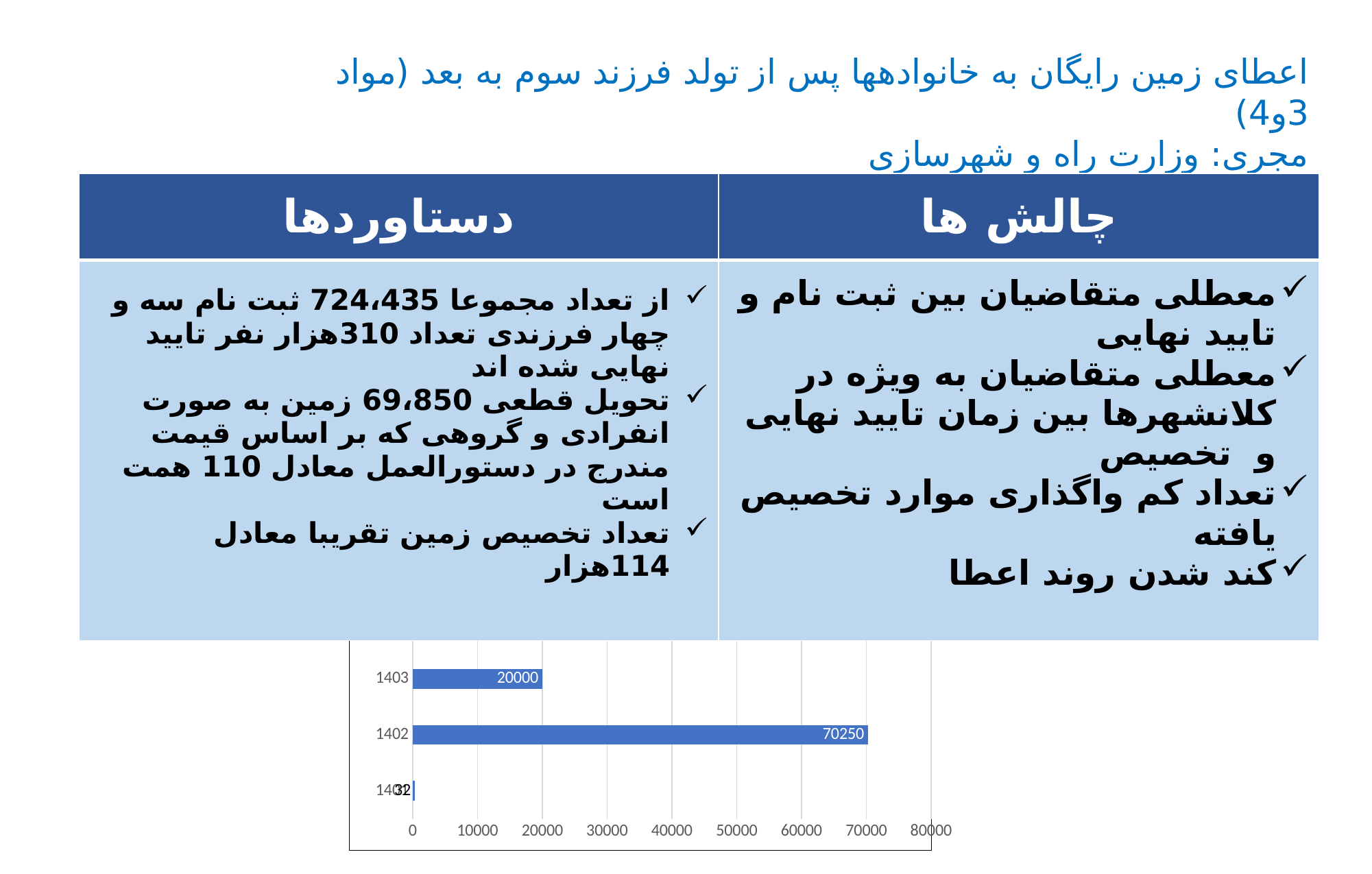
What is the value for 1402 in the bar chart at the bottom of the slide? 70250 What is the value for 1403 in the bar chart at the bottom of the slide? 20000 What is the difference between the values for 1402 and 1403 in the bar chart? 50250 What colour are the bars in the chart at the bottom of the slide? blue What kind of chart is shown at the bottom of the slide? bar chart Which category has the highest value in the bar chart? 1402 How many bars are shown in the chart at the bottom of the slide? 3 Which is larger in the bar chart, the value for 1402 or the value for 1403? 1402 Is the value for 1403 in the bar chart greater or less than 30000? less Is the value for 1402 in the bar chart greater or less than 60000? greater What is the maximum value shown on the horizontal axis of the bar chart? 80000